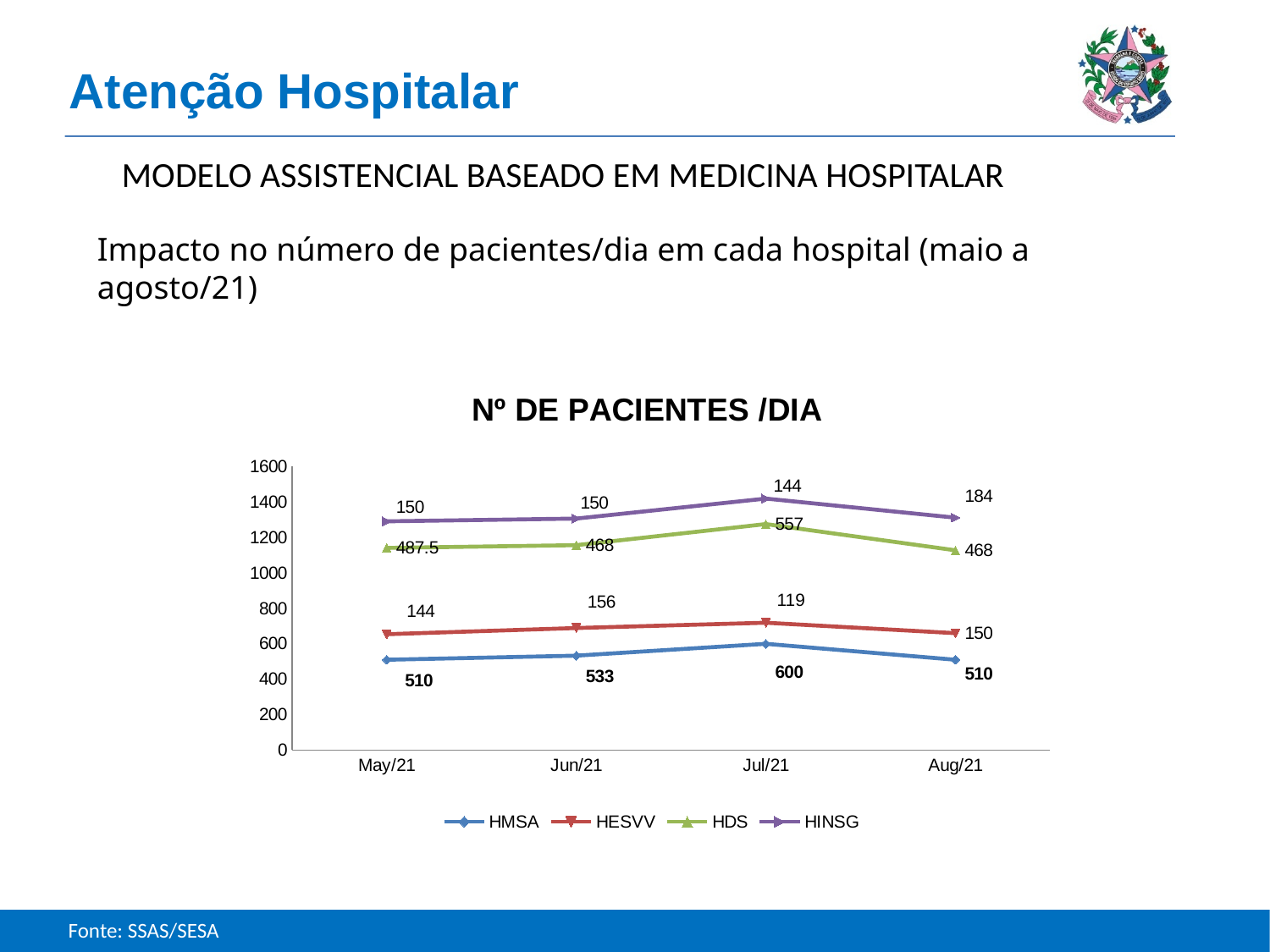
What is the title of the chart? Nº DE PACIENTES /DIA In which month is the HESVV value lowest? Jul/21 In which month is the HMSA value highest? Jul/21 What is the HINSG value for Aug/21? 184 What is the HESVV value for Jun/21? 156 What is the HDS value for May/21? 487.5 What is the HMSA value for Jul/21? 600 How many series does the legend list? 4 What is the difference between the HMSA values for Jul/21 and May/21? 90 Which is larger, the HDS value for Jul/21 or the HDS value for Jun/21? Jul/21 How many months are shown on the x axis? 4 What kind of chart is shown on the slide? Line chart